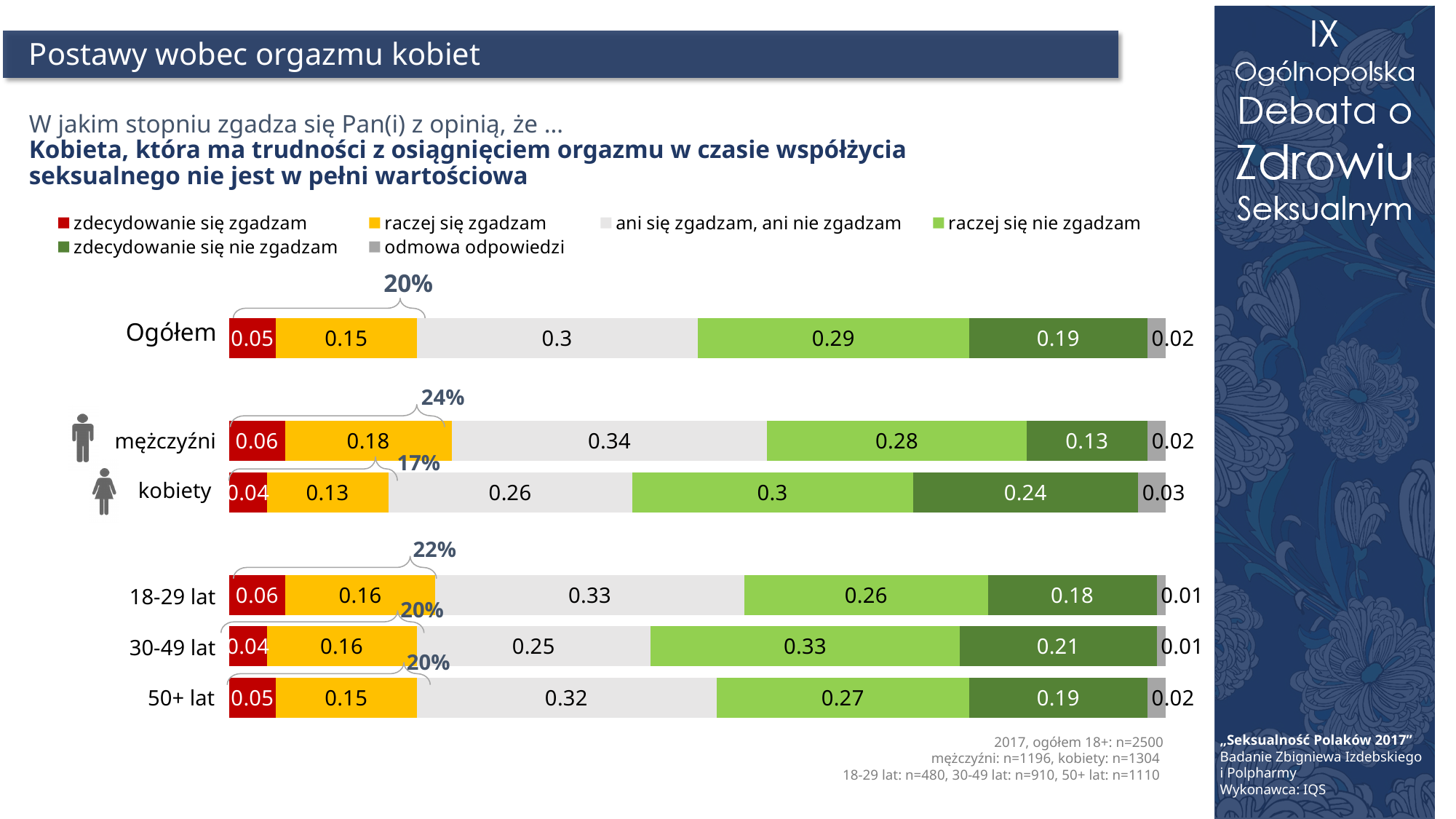
What is the value for 'zdecydowanie się nie zgadzam' in the kobiety bar? 0.24 What kind of chart is shown on the slide? stacked bar chart What is the value for 'raczej się nie zgadzam' in the 30-49 lat bar? 0.33 Which has the larger 'ani się zgadzam, ani nie zgadzam' value: 18-29 lat or 30-49 lat? 18-29 lat What colour represents 'raczej się zgadzam' in the legend? yellow How many series does the legend list? 6 What percentage is shown above the bracket for the mężczyźni bar? 24% What is the difference between the 'zdecydowanie się nie zgadzam' values for kobiety and mężczyźni? 0.11 What is the value for 'ani się zgadzam, ani nie zgadzam' in the mężczyźni bar? 0.34 Which category has the highest value for 'zdecydowanie się nie zgadzam'? kobiety Which category has the lowest value for 'zdecydowanie się nie zgadzam'? mężczyźni How many category bars are shown in the chart? 6